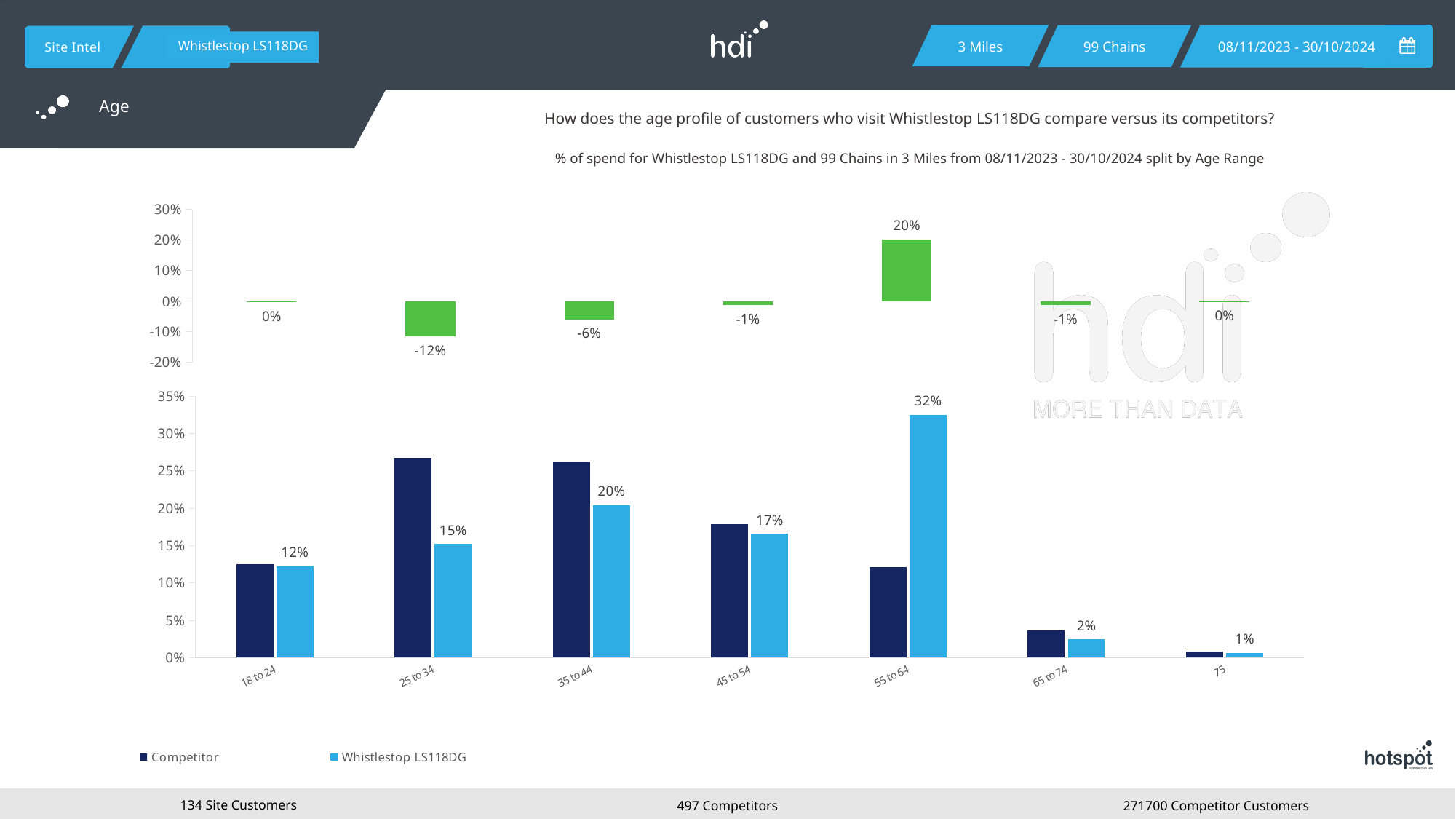
On the bottom chart, is the Competitor value for 55 to 64 greater or less than 15%? less On the bottom chart, what is the difference between the Whistlestop LS118DG values for 55 to 64 and 35 to 44? 12 percentage points On the top chart, what is the value shown for the 55 to 64 age range? 20% On the bottom chart, for the 35 to 44 age range, which series has the larger value, Competitor or Whistlestop LS118DG? Competitor On the bottom chart, which age range has the highest Whistlestop LS118DG value? 55 to 64 How many series does the legend of the bottom chart list? 2 On the top chart, which age range has the highest value? 55 to 64 On the top chart, what is the value shown for the 35 to 44 age range? -6% On the bottom chart, what is the Whistlestop LS118DG value for the 18 to 24 age range? 12% On the top chart, which age range has the lowest value? 25 to 34 On the bottom chart, is the Competitor value for 25 to 34 greater or less than 25%? greater How many age range categories are shown on the bottom chart? 7